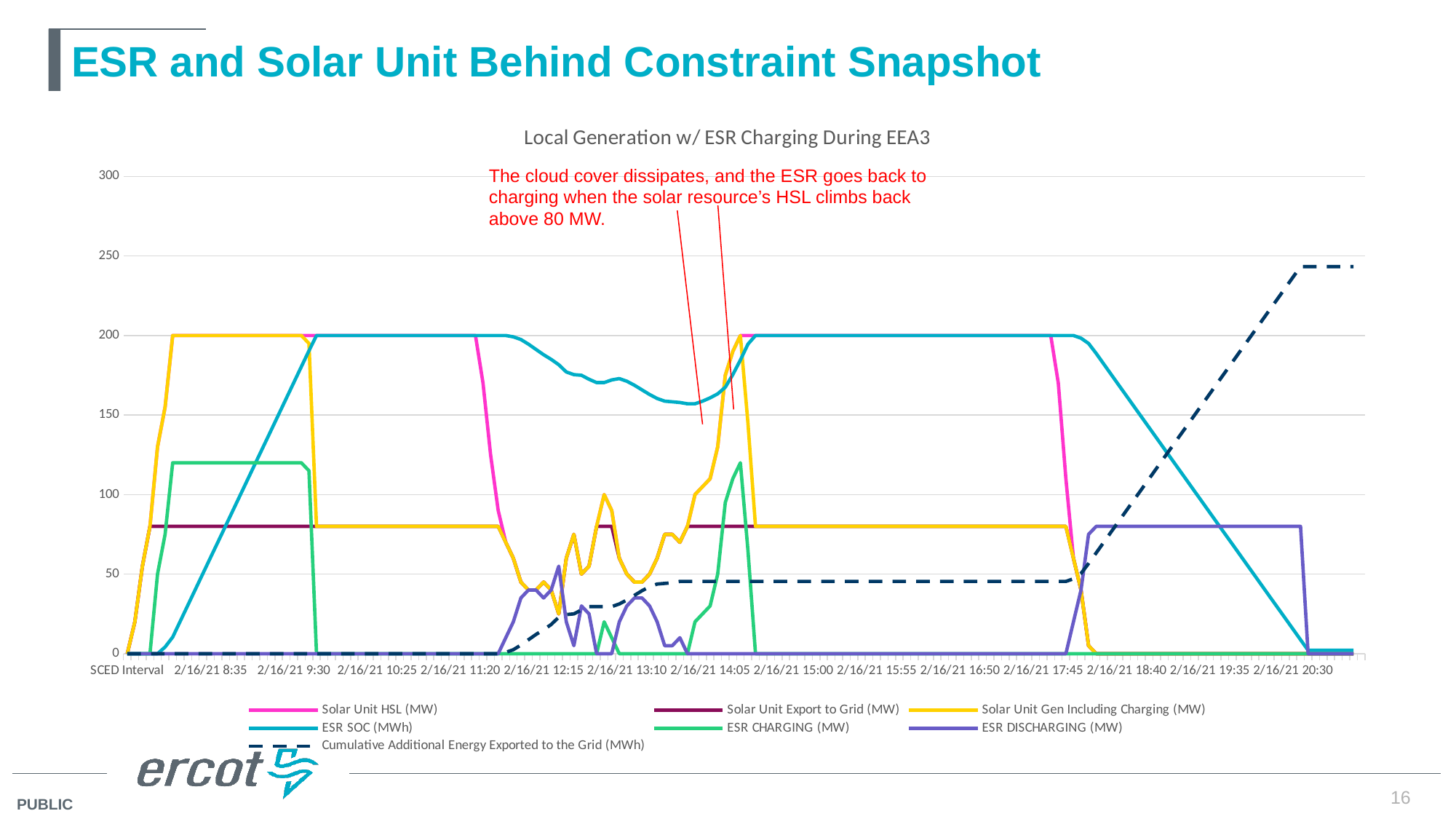
Which series reaches the highest value anywhere on the chart? Cumulative Additional Energy Exported to the Grid (MWh) Is the value for ESR CHARGING (MW) at 2/16/21 9:30 greater or less than 100? greater Does the ESR SOC (MWh) series rise or fall between 2/16/21 18:40 and 2/16/21 20:30? Fall What is the title of the chart? Local Generation w/ ESR Charging During EEA3 Does the Cumulative Additional Energy Exported to the Grid (MWh) series rise or fall overall from left to right? Rise How many series does the chart's legend list? 7 Is the value for ESR SOC (MWh) at 2/16/21 15:00 greater or less than 150? greater Is the value for Solar Unit Export to Grid (MW) at 2/16/21 10:25 greater or less than 100? less What kind of chart is shown on the slide? Line chart Which series is drawn as a dashed line in the chart? Cumulative Additional Energy Exported to the Grid (MWh)